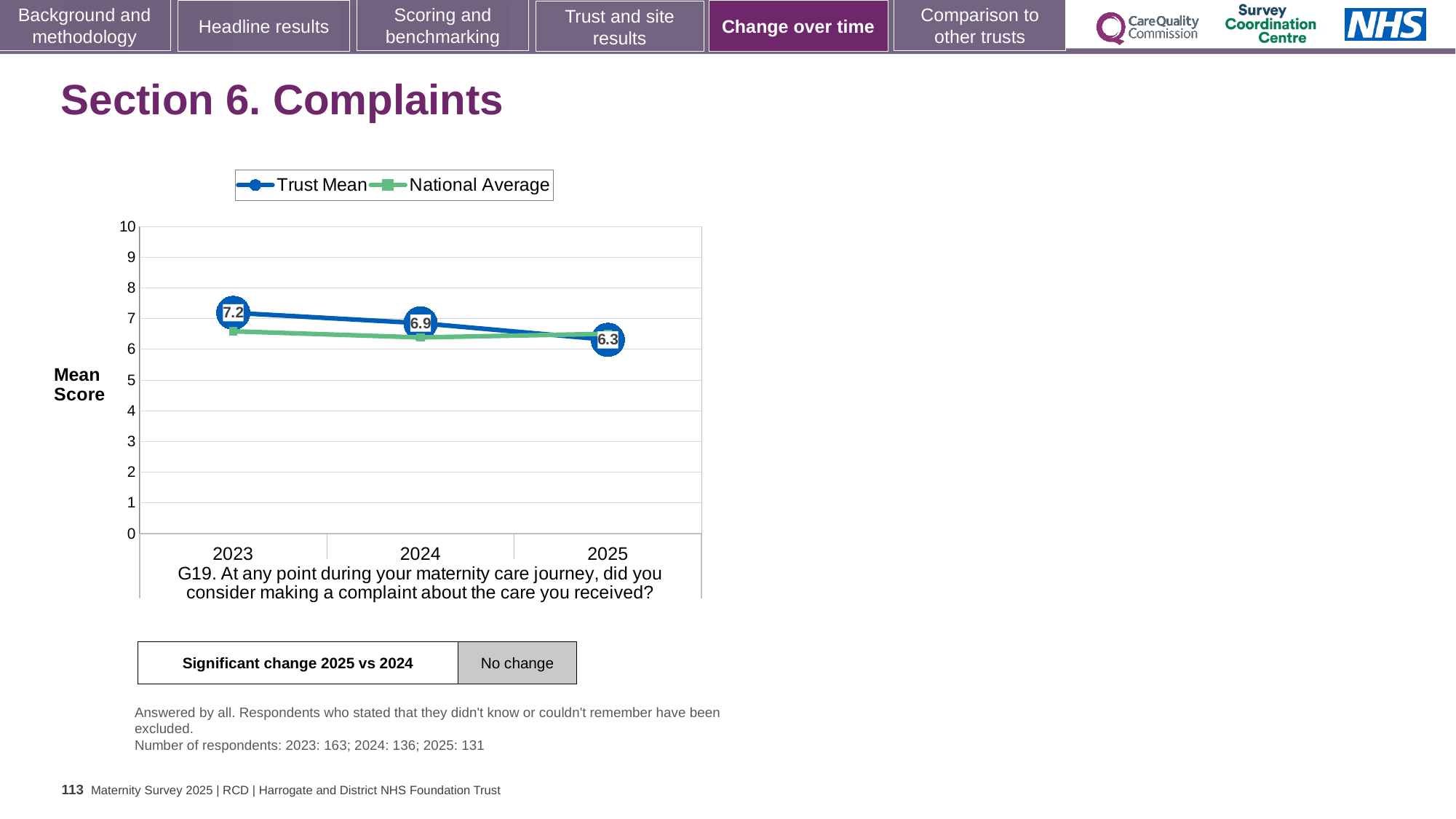
What kind of chart is shown on the slide? Line chart What is the difference between the Trust Mean score in 2023 and in 2025? 0.9 In which year is the Trust Mean score lowest? 2025 In which year is the Trust Mean score highest? 2023 Does the Trust Mean rise or fall from 2023 to 2025? Fall How many years are shown on the x axis of the chart? 3 What is the Trust Mean score for 2023? 7.2 How many series does the chart legend list? 2 What is the Trust Mean score for 2025? 6.3 Is the National Average value for 2023 greater or less than 6? greater What is the Trust Mean score for 2024? 6.9 In 2023, which is higher: the Trust Mean or the National Average? Trust Mean